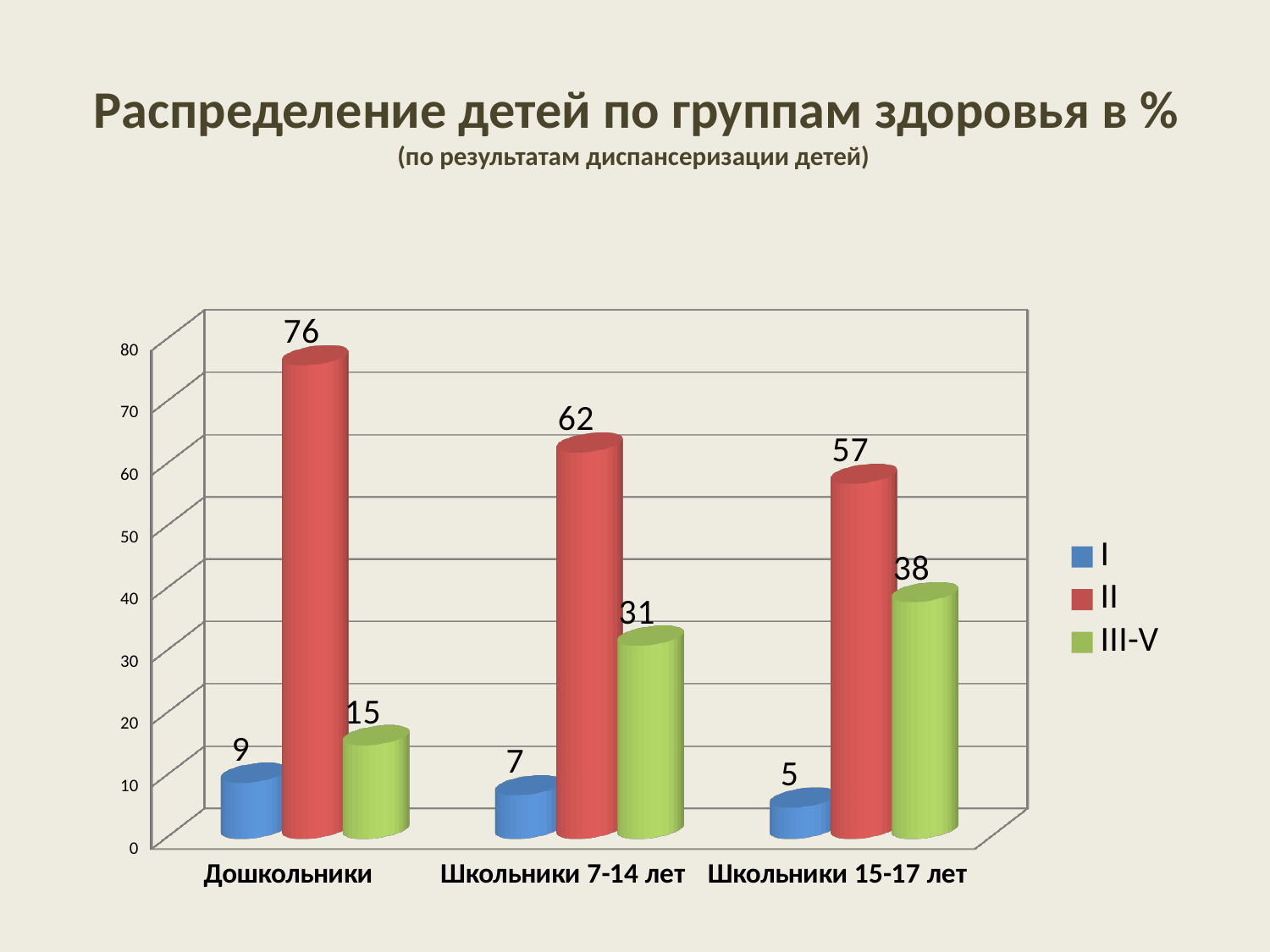
Which age category has the highest value for health group II? Дошкольники How many age categories are shown on the x axis? 3 What is the value for health group III-V among Школьники 7-14 лет? 31 What kind of chart is shown on the slide? bar chart What colour represents health group II in the legend? red What is the difference between the health group II values for Дошкольники and Школьники 15-17 лет? 19 Which is larger: the health group III-V value for Школьники 15-17 лет or for Школьники 7-14 лет? Школьники 15-17 лет How many series does the legend list? 3 What is the value for health group II among Дошкольники? 76 What is the value for health group I among Школьники 15-17 лет? 5 Do the values for health group I rise or fall from Дошкольники to Школьники 15-17 лет? fall Which age category has the lowest value for health group III-V? Дошкольники